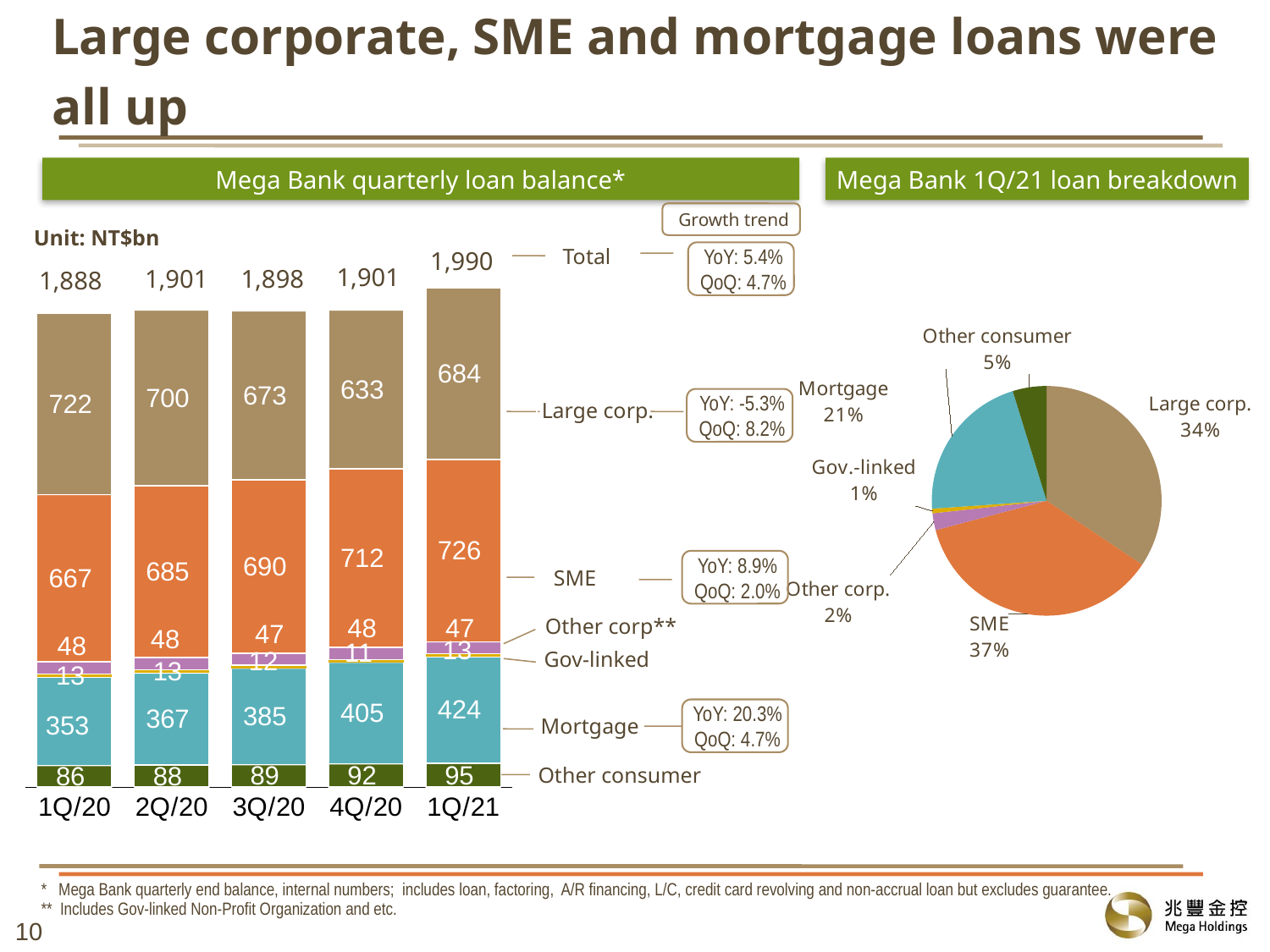
In the Mega Bank quarterly loan balance chart, what is the Large corp. balance in 4Q/20? 633 In the Mega Bank 1Q/21 loan breakdown pie chart, what share does SME account for? 37% In the Mega Bank 1Q/21 loan breakdown pie chart, which category has the smallest share? Gov.-linked In the Mega Bank quarterly loan balance chart, does the Mortgage balance rise or fall from 1Q/20 to 1Q/21? Rise In the Mega Bank quarterly loan balance chart, by how much did the SME balance increase from 1Q/20 to 1Q/21? 59 How many quarters are shown in the Mega Bank quarterly loan balance chart? 5 What kind of chart is the Mega Bank quarterly loan balance chart? Stacked bar chart In the Mega Bank quarterly loan balance chart, what is the Mortgage balance in 1Q/21? 424 In the Mega Bank quarterly loan balance chart, which is larger in 1Q/21, the Large corp. balance or the SME balance? SME In the Mega Bank quarterly loan balance chart, what is the total loan balance for 1Q/21? 1,990 In the Mega Bank quarterly loan balance chart, in which quarter is the Large corp. balance lowest? 4Q/20 In the Mega Bank quarterly loan balance chart, which quarter has the highest total loan balance? 1Q/21